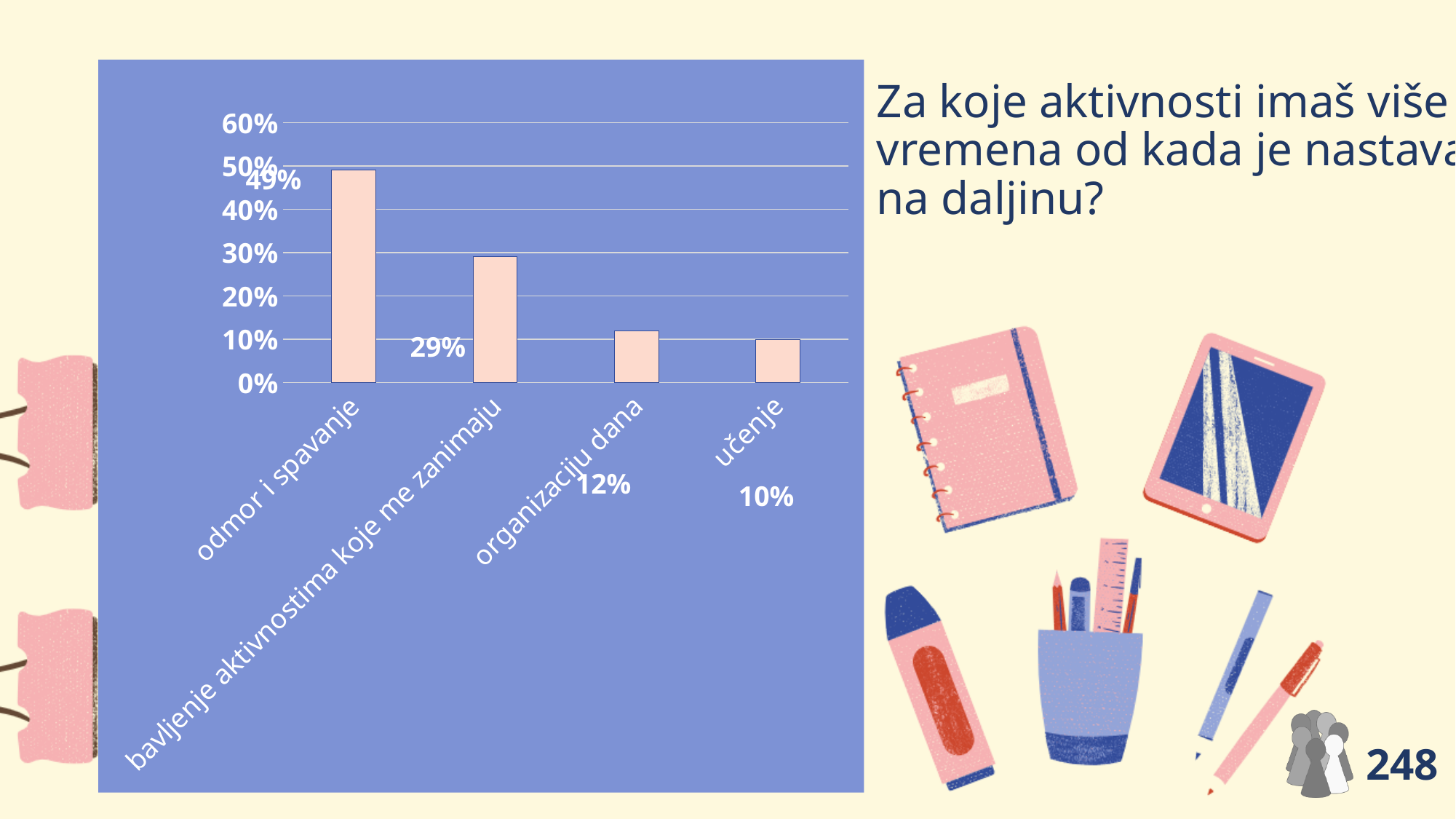
Do the values rise or fall from left to right along the x axis? fall Is the value for "bavljenje aktivnostima koje me zanimaju" greater or less than 20%? greater Which category has the highest value? odmor i spavanje Which category has the lowest value? učenje Which is larger, the value for "organizaciju dana" or the value for "učenje"? organizaciju dana What is the value for "bavljenje aktivnostima koje me zanimaju"? 29% What is the value for "učenje"? 10% What is the value for "odmor i spavanje"? 49% What kind of chart is shown on the slide? bar chart How many categories are shown in the chart? 4 What is the difference between the values for "odmor i spavanje" and "bavljenje aktivnostima koje me zanimaju"? 20% What is the value for "organizaciju dana"? 12%